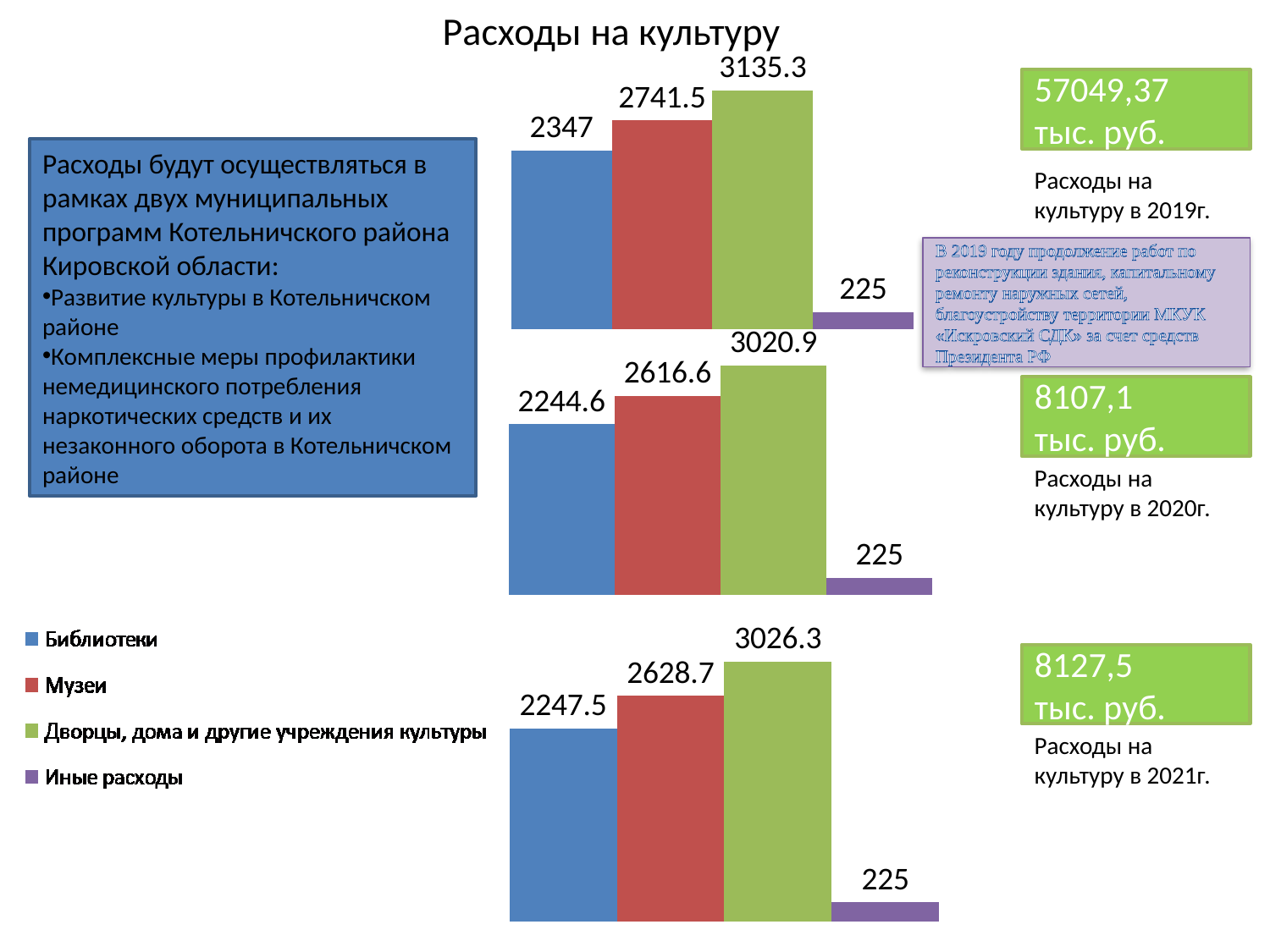
In the top chart (2019), what is the value for Дворцы, дома и другие учреждения культуры? 3135.3 In the bottom chart (2021), what is the value for Иные расходы? 225 In the top chart (2019), what is the difference between the values for Музеи and Библиотеки? 394.5 How many series does the legend list? 4 What kind of chart is the middle chart (2020)? bar chart What colour represents Иные расходы in the legend? purple In the bottom chart (2021), which category has the highest value? Дворцы, дома и другие учреждения культуры In the top chart (2019), what is the value for Библиотеки? 2347 How many bars are shown in the top chart (2019)? 4 In the middle chart (2020), which category has the lowest value? Иные расходы In the bottom chart (2021), which is larger: the value for Музеи or the value for Библиотеки? Музеи In the middle chart (2020), what is the value for Музеи? 2616.6